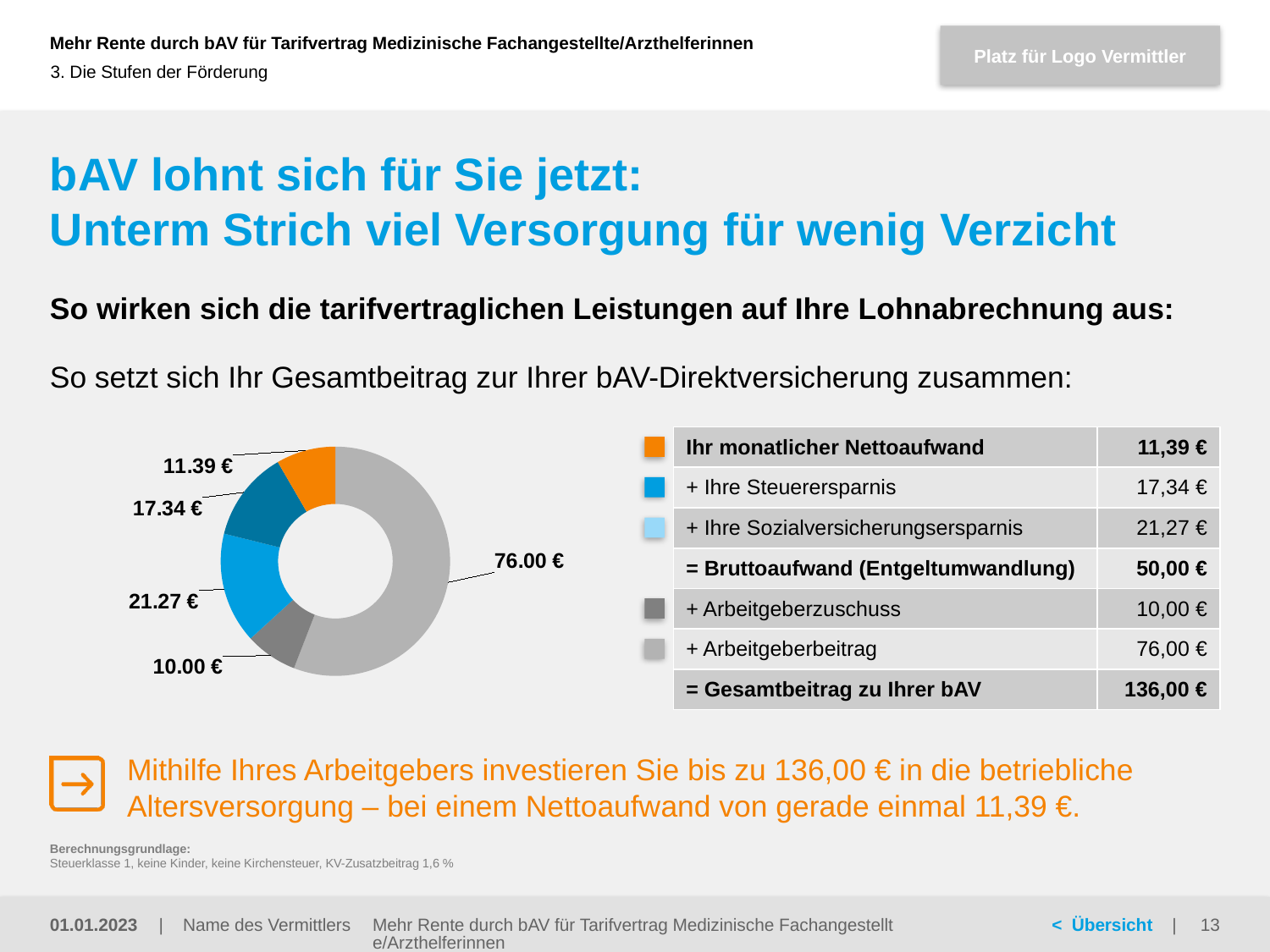
What is the value of the smallest slice in the donut chart? 10.00 € What type of chart is shown on the slide? Pie (donut) chart What is the value of the largest slice in the donut chart? 76.00 € What value is shown for the Sozialversicherungsersparnis slice in the donut chart? 21.27 € What colour is the slice representing Ihr monatlicher Nettoaufwand in the donut chart? Orange Which component has the largest slice in the donut chart? Arbeitgeberbeitrag What value is shown for the Steuerersparnis slice in the donut chart? 17.34 € What is the total of all slices in the donut chart (Gesamtbeitrag zu Ihrer bAV)? 136,00 € What is the difference between the largest slice (76.00 €) and the smallest slice (10.00 €) in the donut chart? 66.00 € How many slices does the donut chart have? 5 Which is larger in the donut chart: the Steuerersparnis slice or the Sozialversicherungsersparnis slice? Sozialversicherungsersparnis What value is shown for the orange slice (Ihr monatlicher Nettoaufwand) in the donut chart? 11.39 €